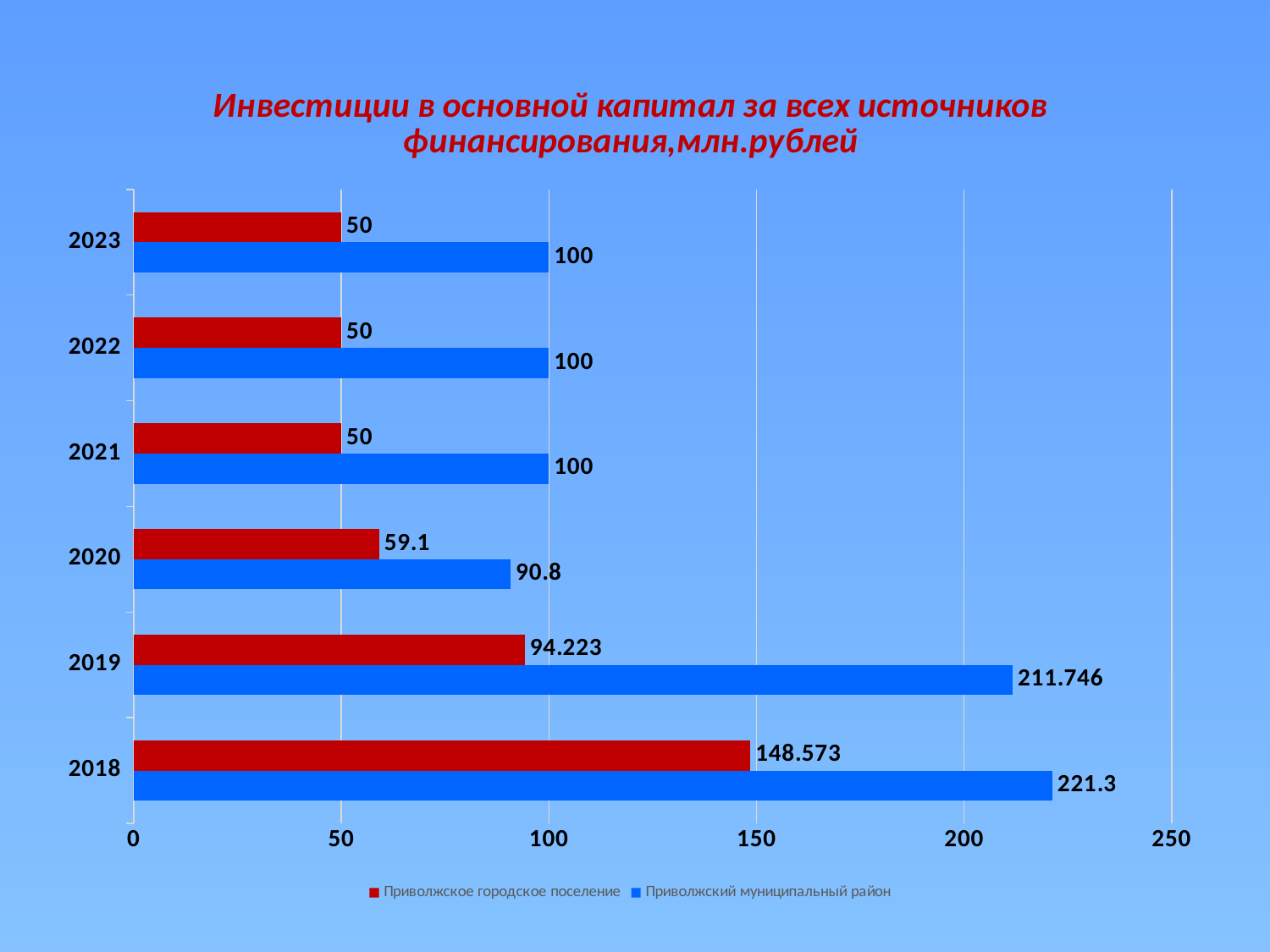
What is the difference between Приволжский муниципальный район and Приволжское городское поселение in 2018? 72.727 What is the value for Приволжский муниципальный район in 2020? 90.8 In which year is the value for Приволжское городское поселение highest? 2018 What is the value for Приволжское городское поселение in 2023? 50 What kind of chart is shown on the slide? Bar chart Which is larger in 2020: Приволжское городское поселение or Приволжский муниципальный район? Приволжский муниципальный район What is the value for Приволжское городское поселение in 2019? 94.223 In which year is the value for Приволжский муниципальный район lowest? 2020 How many years are shown on the chart? 6 Which colour represents Приволжское городское поселение in the chart? Red What is the value for Приволжский муниципальный район in 2018? 221.3 How many series does the legend list? 2